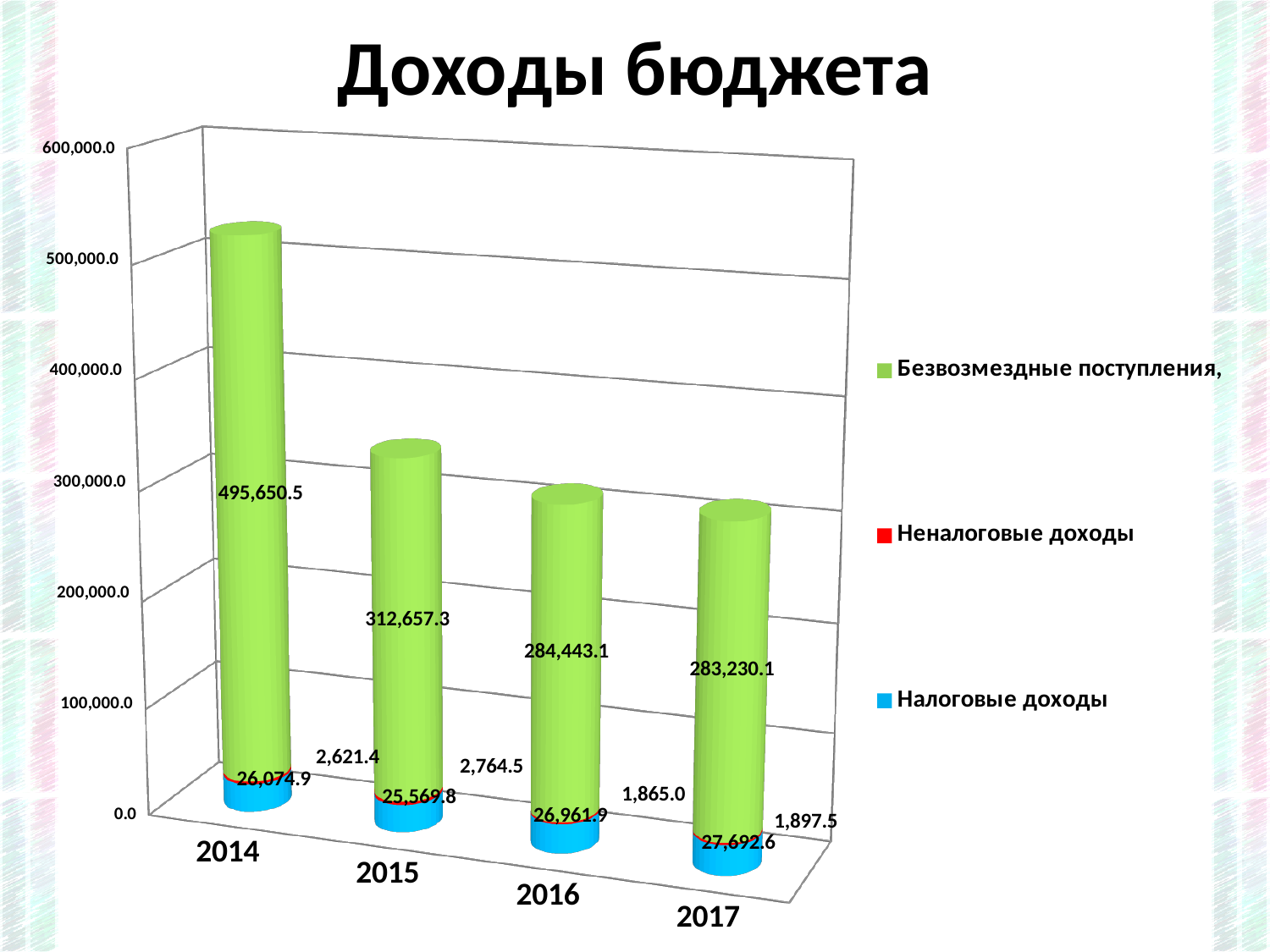
How many years are shown on the x axis? 4 Does Безвозмездные поступления rise or fall from 2014 to 2017? Fall Which is larger: Налоговые доходы in 2016 or in 2015? 2016 What is the difference between Безвозмездные поступления in 2014 and 2015? 182,993.2 In which year is Безвозмездные поступления highest? 2014 What is the value of Безвозмездные поступления for 2014? 495,650.5 What is the value of Налоговые доходы for 2017? 27,692.6 How many series does the legend list? 3 In which year is Неналоговые доходы lowest? 2016 What is the value of Неналоговые доходы for 2015? 2,764.5 What is the total of the stacked bar for 2016? 313,270.0 What kind of chart is shown? Stacked bar chart